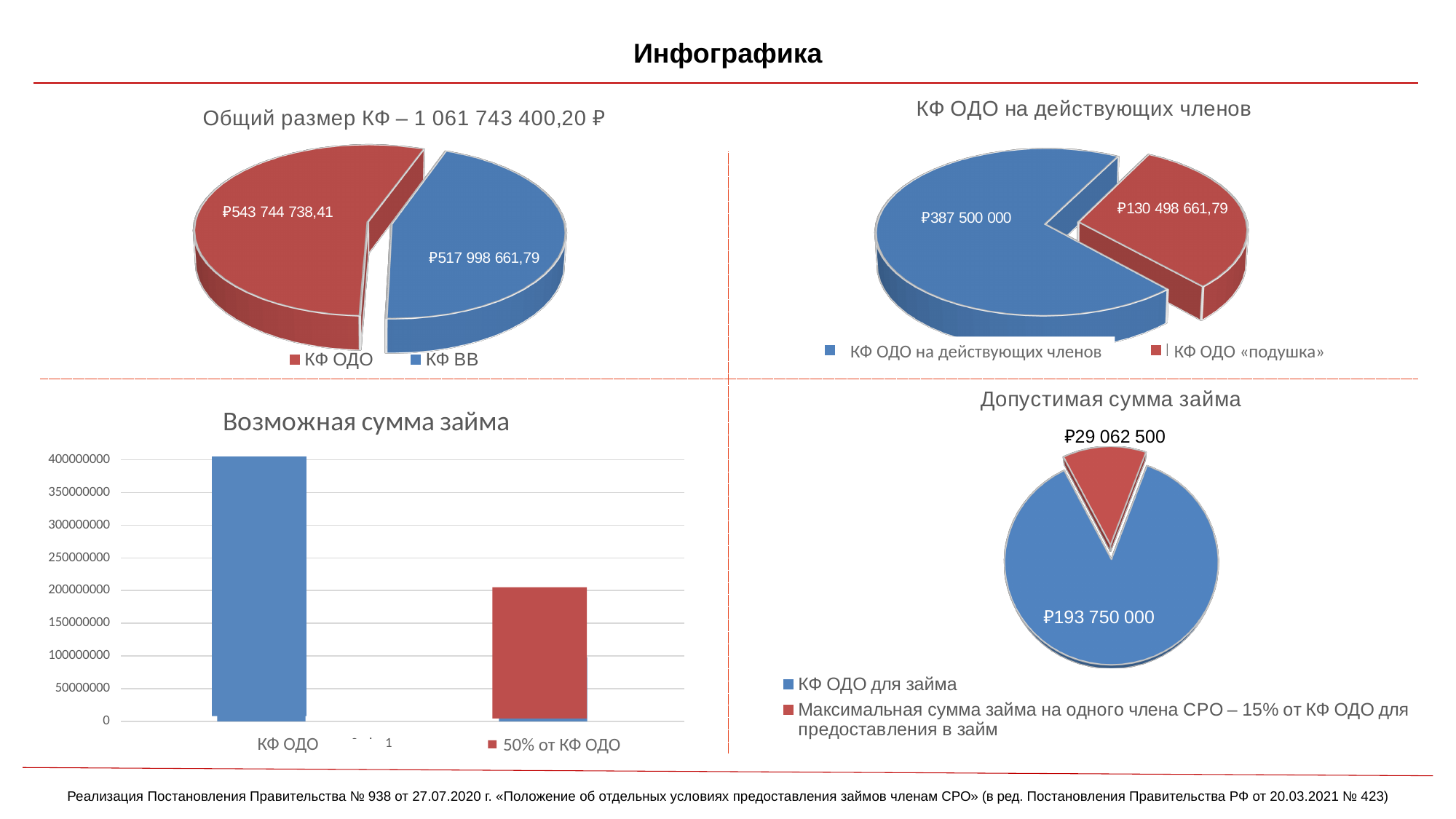
In the pie chart titled "Общий размер КФ – 1 061 743 400,20 ₽", what is the value for КФ ВВ? ₽517 998 661,79 In the pie chart titled "Допустимая сумма займа", what is the value for КФ ОДО для займа? ₽193 750 000 In the pie chart titled "КФ ОДО на действующих членов", what is the value for КФ ОДО «подушка»? ₽130 498 661,79 In the pie chart titled "КФ ОДО на действующих членов", which slice is the largest? КФ ОДО на действующих членов In the pie chart titled "Общий размер КФ – 1 061 743 400,20 ₽", which slice is larger, КФ ОДО or КФ ВВ? КФ ОДО In the pie chart titled "КФ ОДО на действующих членов", what is the difference between the two slices? ₽257 001 338,21 In the pie chart titled "КФ ОДО на действующих членов", what is the value for the slice КФ ОДО на действующих членов? ₽387 500 000 In the pie chart titled "Общий размер КФ – 1 061 743 400,20 ₽", what is the value for КФ ОДО? ₽543 744 738,41 In the chart titled "Возможная сумма займа", is the value for 50% от КФ ОДО greater or less than 250000000? less What kind of chart is the chart titled "Возможная сумма займа"? bar chart In the chart titled "Возможная сумма займа", is the value for КФ ОДО greater or less than 350000000? greater In the pie chart titled "Допустимая сумма займа", what is the value of the red slice (Максимальная сумма займа на одного члена СРО)? ₽29 062 500